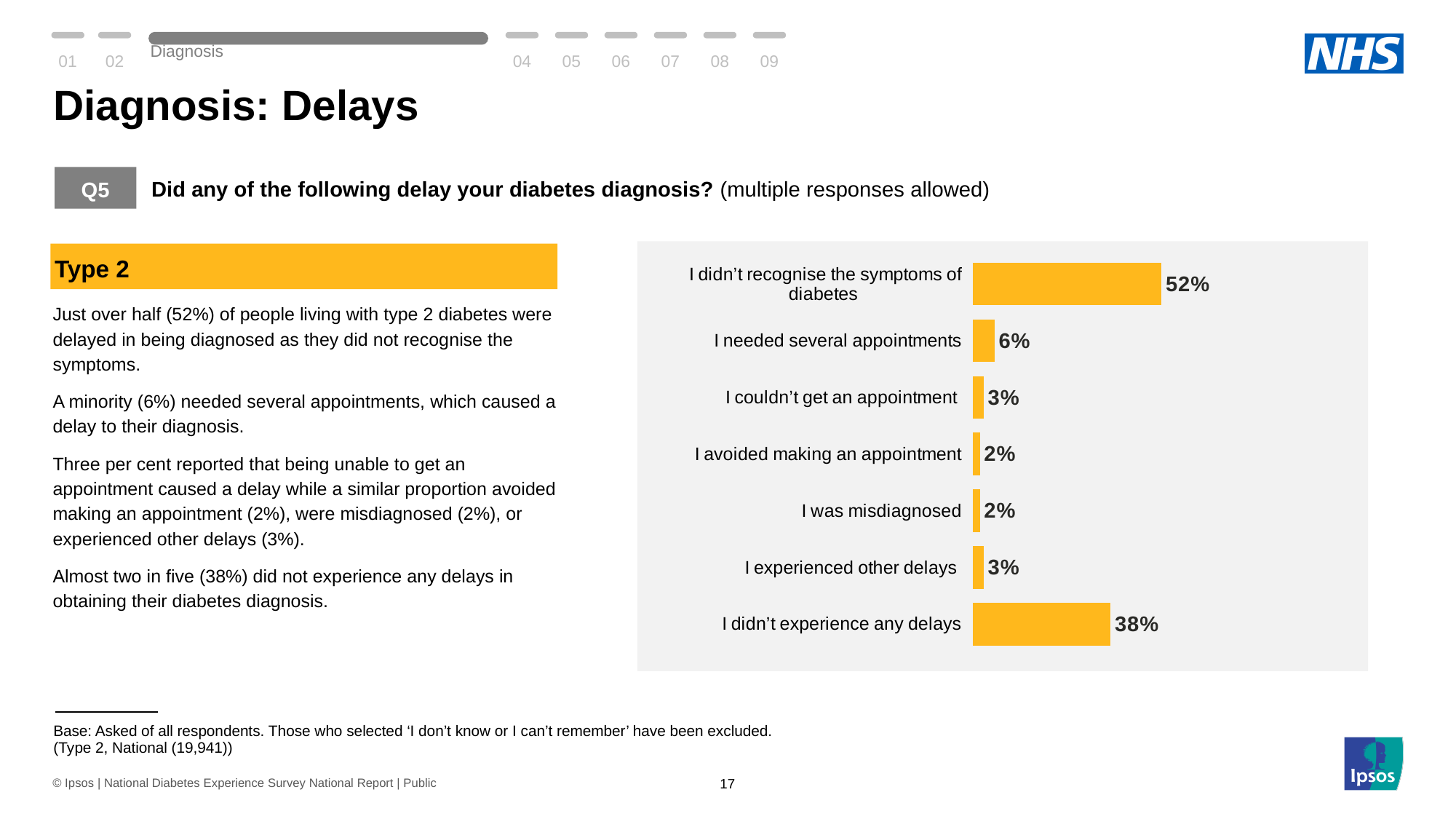
What percentage of respondents said they needed several appointments? 6% What kind of chart is shown on the slide? Bar chart Which two categories share the lowest value of 2%? I avoided making an appointment; I was misdiagnosed What percentage of respondents said they didn't recognise the symptoms of diabetes? 52% What is the difference between the value for 'I didn't recognise the symptoms of diabetes' and 'I didn't experience any delays'? 14% What colour are the bars in the chart? Orange/yellow What percentage of respondents said they couldn't get an appointment? 3% Which category has the highest value in the chart? I didn't recognise the symptoms of diabetes How many categories are shown in the chart? 7 Which is larger: the value for 'I needed several appointments' or 'I couldn't get an appointment'? I needed several appointments What is the difference between the value for 'I needed several appointments' and 'I was misdiagnosed'? 4% What percentage of respondents said they didn't experience any delays? 38%